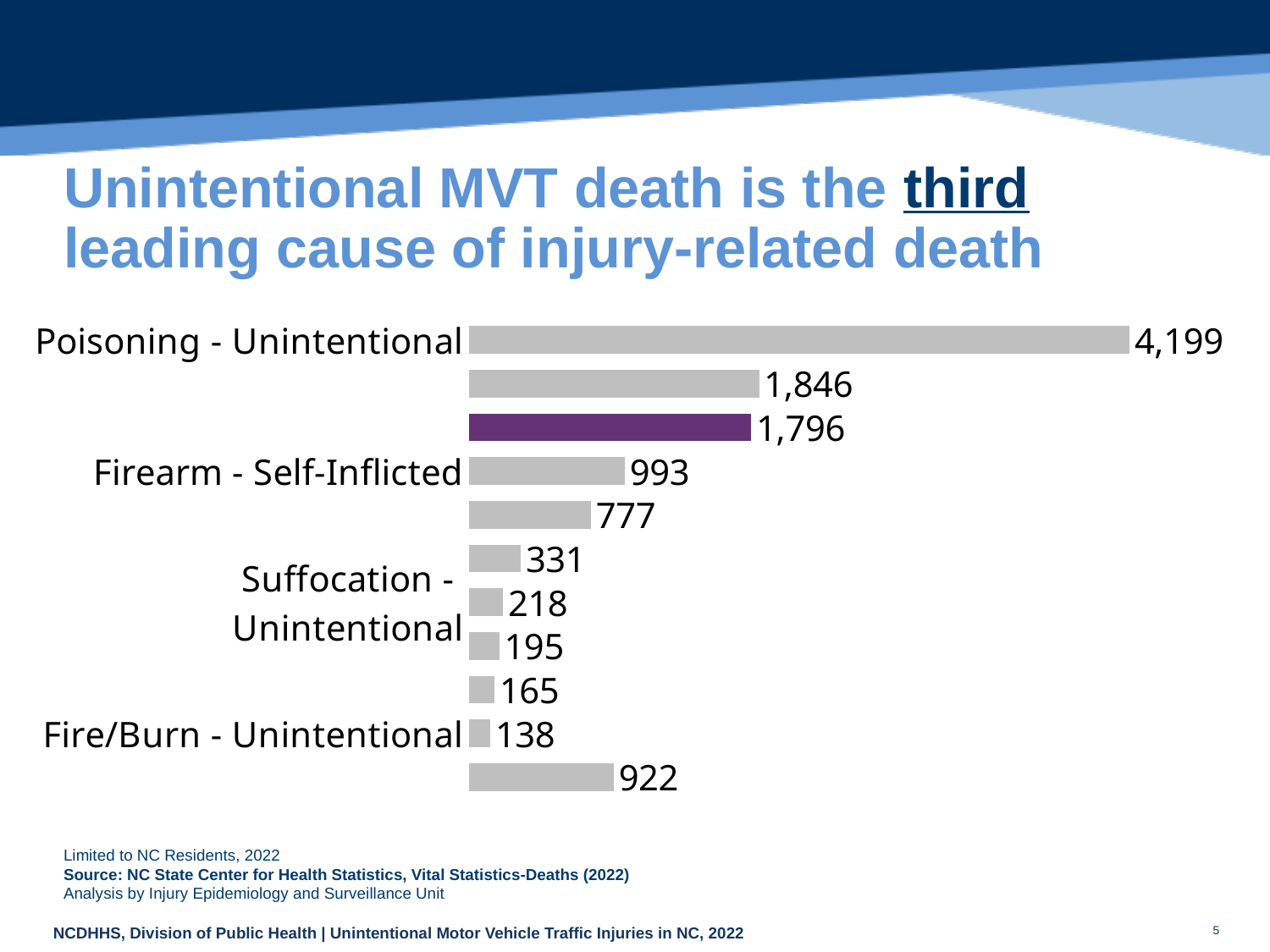
What is the value for Firearm - Self-Inflicted? 993 Which is larger, the value for Firearm - Self-Inflicted or the value for Fire/Burn - Unintentional? Firearm - Self-Inflicted What is the difference between the values for Firearm - Self-Inflicted and Fire/Burn - Unintentional? 855 How many bars are shown in the chart? 11 What is the value for Poisoning - Unintentional? 4,199 What is the value for Fire/Burn - Unintentional? 138 What kind of chart is shown on the slide? Bar chart What is the difference between the values for Poisoning - Unintentional and Firearm - Self-Inflicted? 3,206 What value is shown on the purple bar? 1,796 What is the value for Suffocation - Unintentional? 218 Which category has the lowest value? Fire/Burn - Unintentional Which category has the highest value? Poisoning - Unintentional